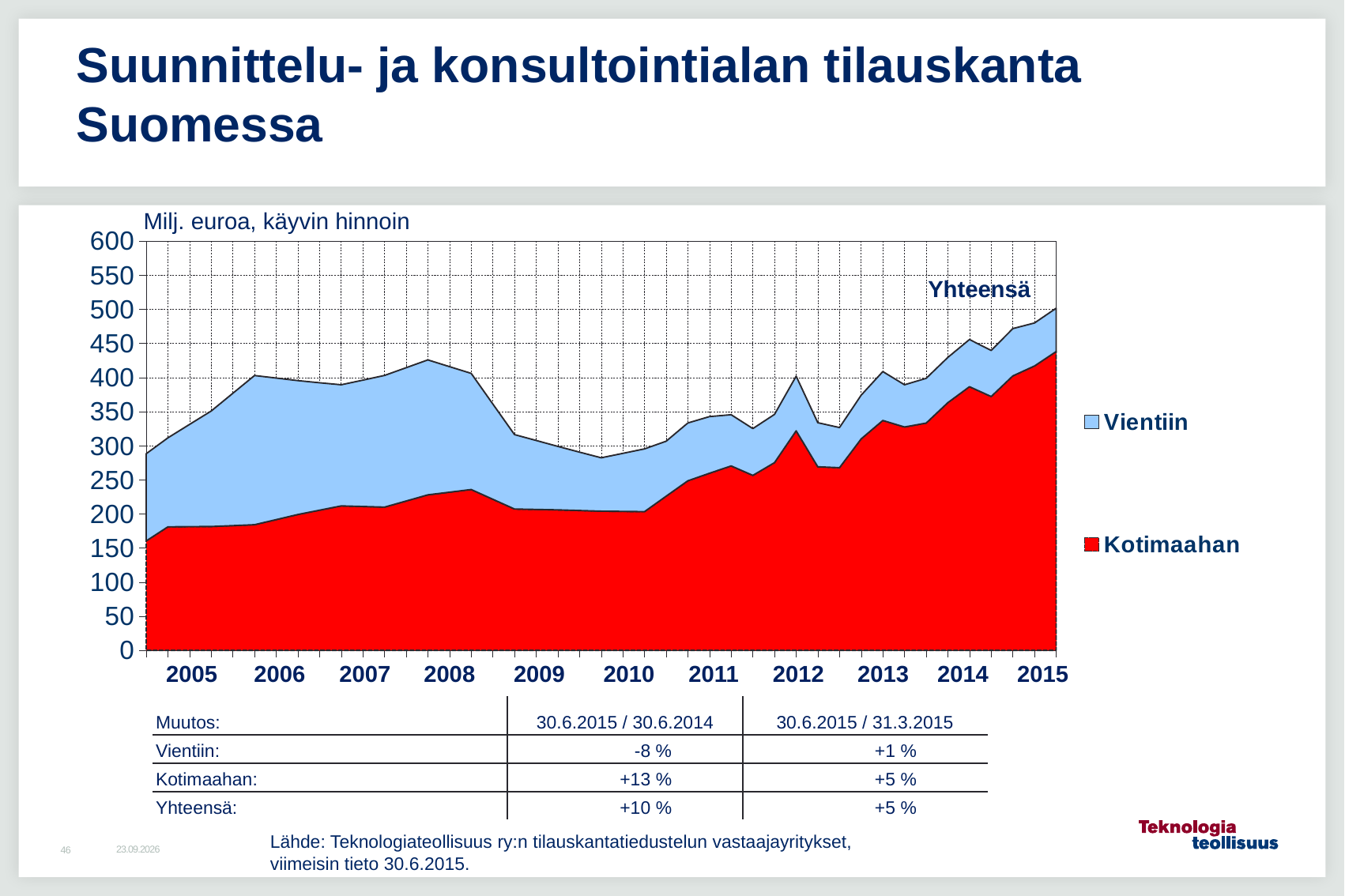
What are the two series named in the chart legend? Vientiin and Kotimaahan In which year does the total (Yhteensä) reach its highest level? 2015 Is the total (Yhteensä) value in 2010 greater or less than 350? less Is the Kotimaahan value at the start of 2005 greater or less than 200? less Is the Kotimaahan value at the end of 2015 greater or less than 400? greater What kind of chart is shown on the slide? area chart How many years are labelled on the x axis of the chart? 11 How many series does the chart legend list? 2 Does the Kotimaahan series rise or fall overall from 2005 to 2015? rise At the end of 2015, which is larger, the Kotimaahan portion or the Vientiin portion? Kotimaahan What unit label is printed above the chart's y axis? Milj. euroa, käyvin hinnoin